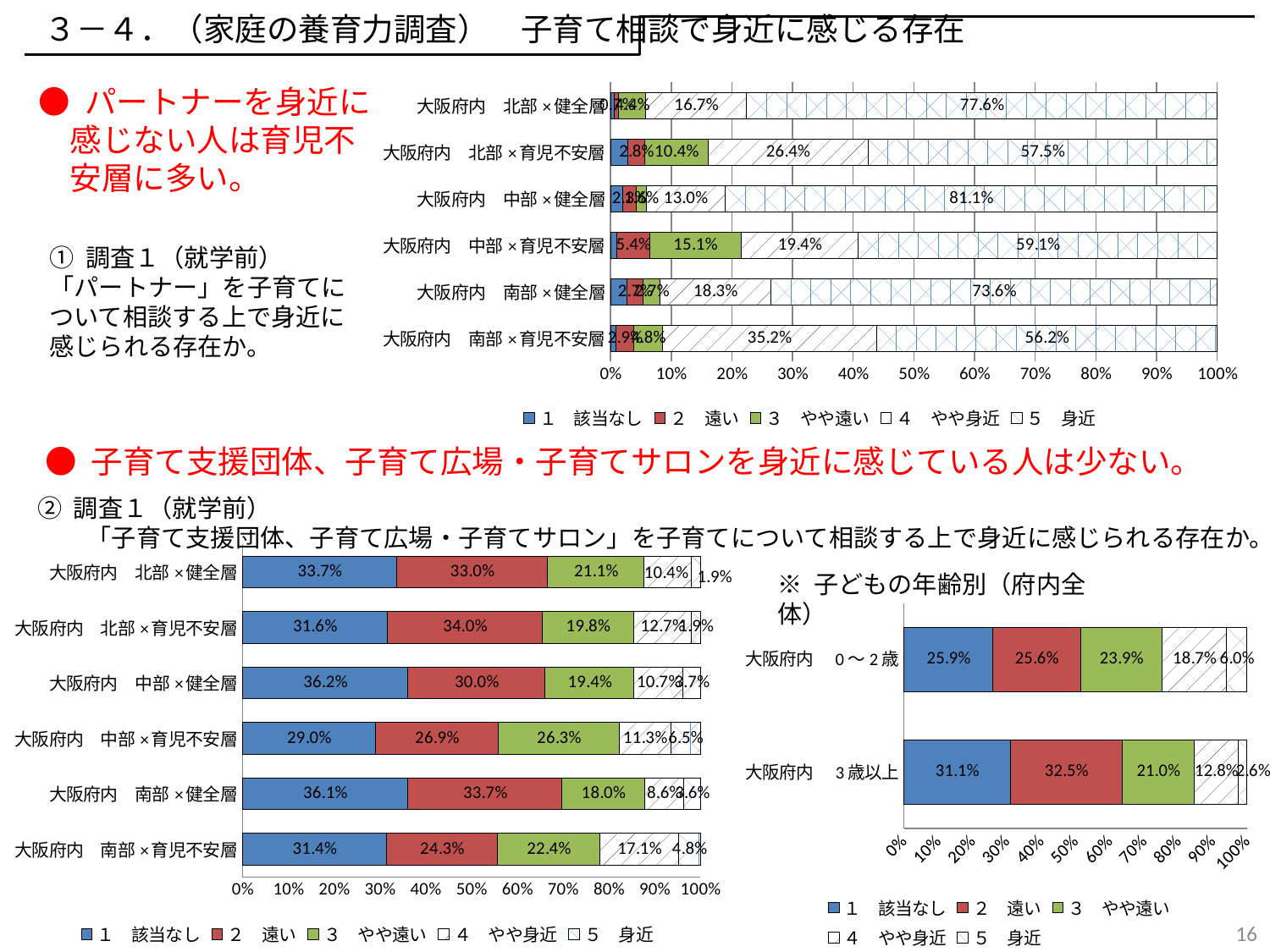
In the top chart (パートナー), what is the value of the 4 やや身近 segment for 大阪府内 南部×育児不安層? 35.2% In the bottom-right chart (子どもの年齢別), what is the difference between the 5 身近 values for 大阪府内 0〜2歳 and 大阪府内 3歳以上? 3.4% In the top chart (パートナー), what is the difference between the 5 身近 values for 大阪府内 北部×健全層 and 大阪府内 北部×育児不安層? 20.1% In the top chart (パートナー), how many series does the legend list? 5 In the bottom-left chart (子育て支援団体), which category has the highest 4 やや身近 value? 大阪府内 南部×育児不安層 In the bottom-right chart (子どもの年齢別), what is the value of the 3 やや遠い segment for 大阪府内 0〜2歳? 23.9% In the bottom-left chart (子育て支援団体), which category has the lowest 1 該当なし value? 大阪府内 中部×育児不安層 In the bottom-left chart (子育て支援団体), what is the value of the 1 該当なし segment for 大阪府内 中部×健全層? 36.2% In the top chart (パートナー), which category has the highest 5 身近 value? 大阪府内 中部×健全層 In the top chart (パートナー), what is the value of the 5 身近 segment for 大阪府内 北部×健全層? 77.6% In the bottom-left chart (子育て支援団体), how many categories are plotted? 6 In the bottom-left chart (子育て支援団体), which is larger: the 2 遠い value for 大阪府内 北部×育児不安層 or for 大阪府内 南部×育児不安層? 大阪府内 北部×育児不安層